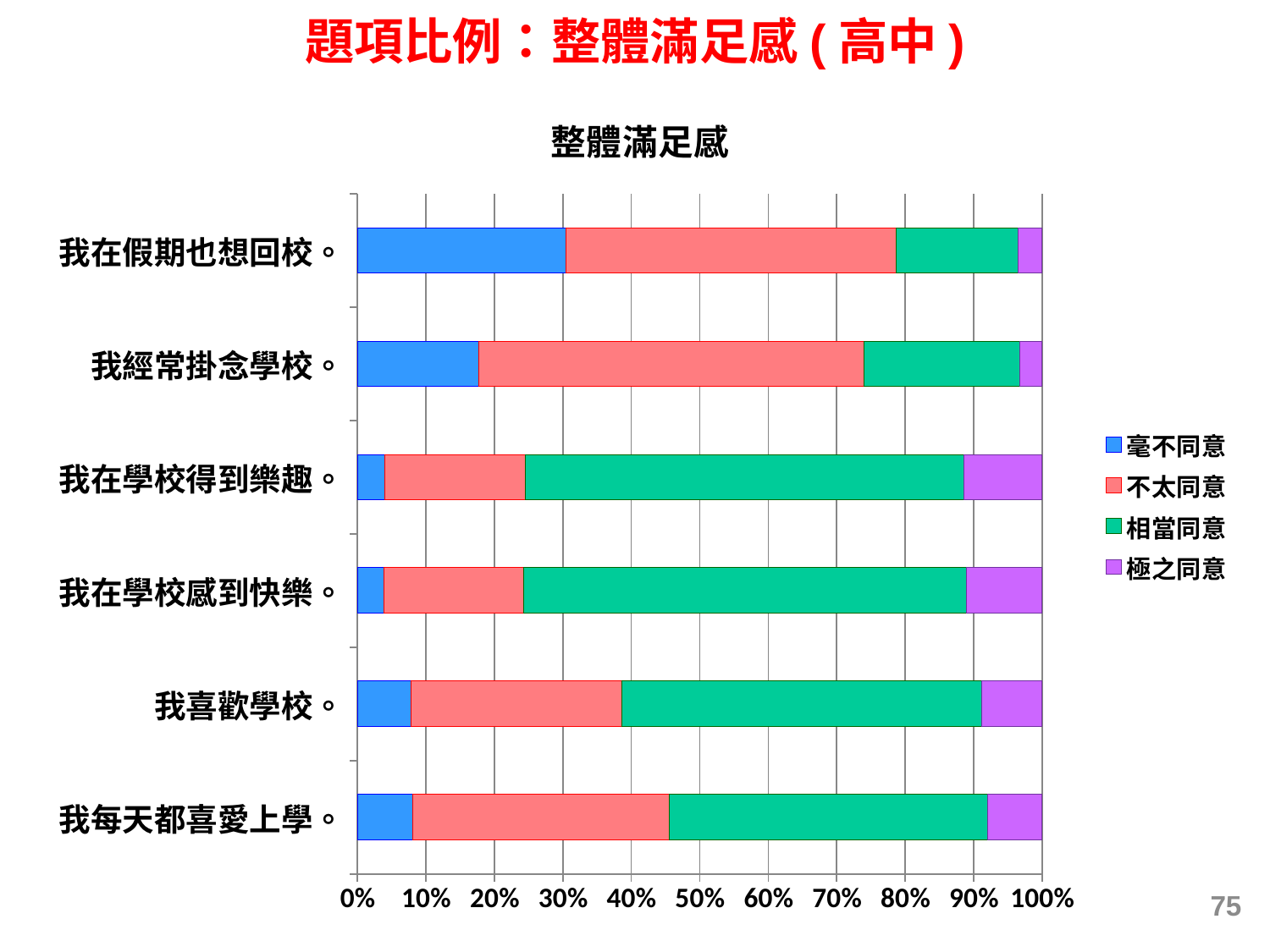
What kind of chart is shown on the slide? stacked bar chart Is the 毫不同意 value for 我經常掛念學校。 greater or less than 10%? greater What do the segments of the bar for 我喜歡學校。 add up to? 100% Is the 不太同意 value for 我每天都喜愛上學。 greater or less than 30%? greater How many series does the legend list? 4 What is the title of the chart? 整體滿足感 Which statement has the largest 毫不同意 segment? 我在假期也想回校。 Is the 毫不同意 value for 我在假期也想回校。 greater or less than 20%? greater Which legend entry is shown in green? 相當同意 How many statements (categories) are plotted on the chart? 6 Which statement has the largest 不太同意 segment? 我經常掛念學校。 Which is larger: the 毫不同意 segment for 我在假期也想回校。 or for 我經常掛念學校。? 我在假期也想回校。